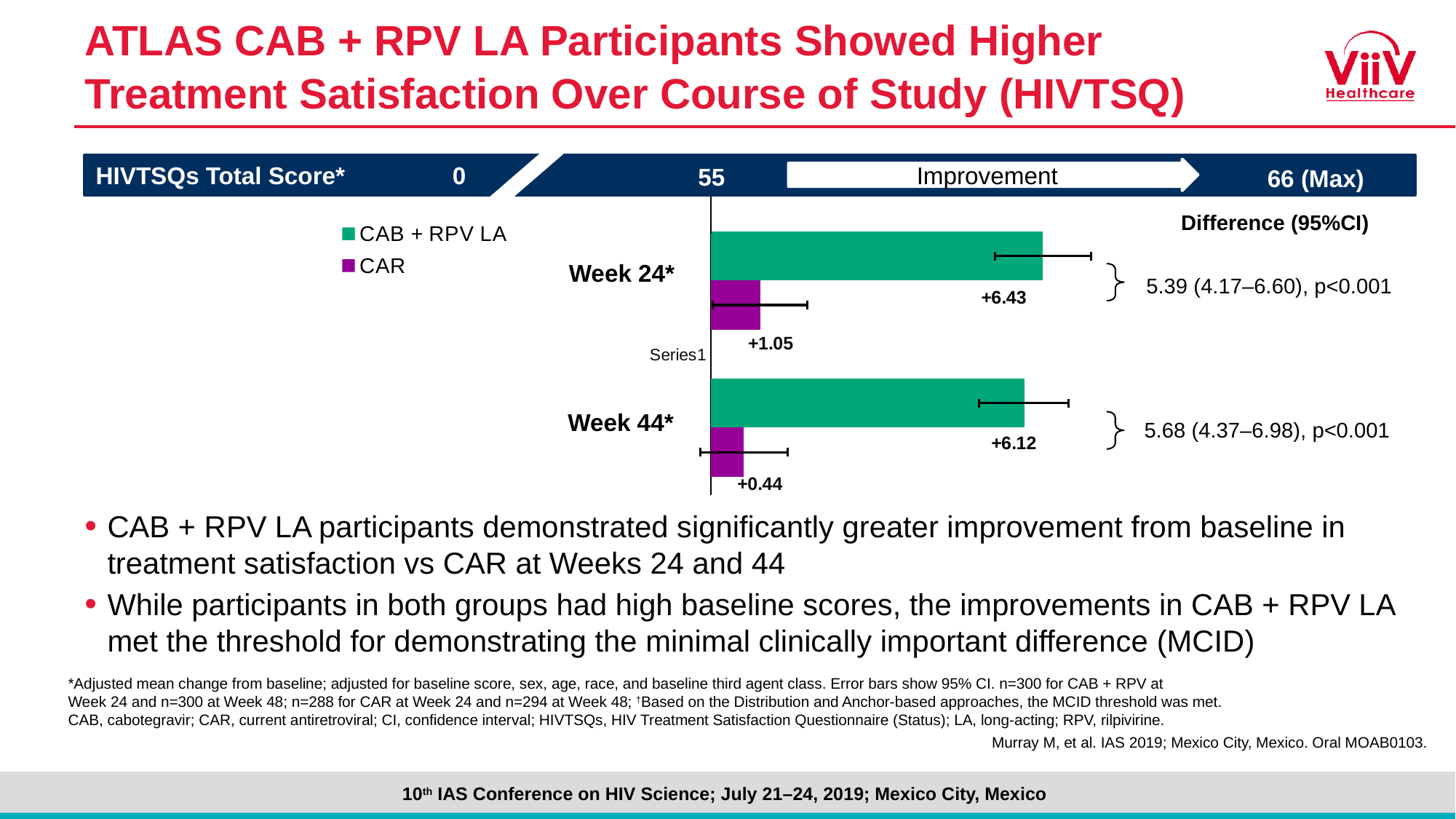
What is the value for CAB + RPV LA at Week 44*? +6.12 How many time-point categories are plotted in the chart? 2 What is the value for CAR at Week 24*? +1.05 What kind of chart is shown on the slide? Bar chart What is the value for CAR at Week 44*? +0.44 How many series does the legend list? 2 Which bar in the chart has the highest value? CAB + RPV LA at Week 24* What is the difference between the CAB + RPV LA and CAR values at Week 24*? 5.38 Which bar in the chart has the lowest value? CAR at Week 44* Which series has the higher value at Week 44*, CAB + RPV LA or CAR? CAB + RPV LA What is the value for CAB + RPV LA at Week 24*? +6.43 What is the difference between the CAB + RPV LA values at Week 24* and Week 44*? 0.31